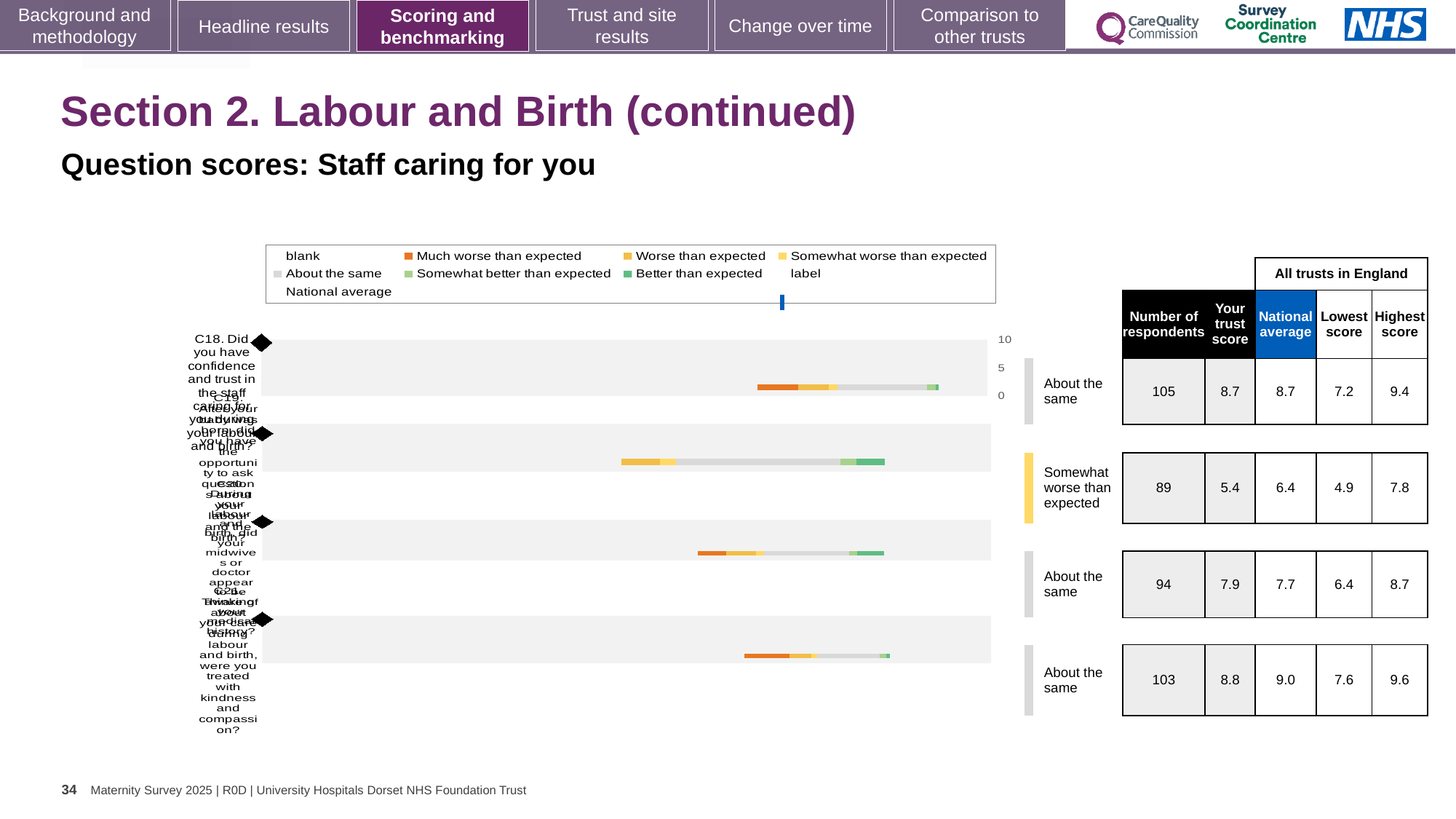
What colour is the band for the row rated 'Somewhat worse than expected'? yellow What is the lowest 'Your trust score' shown in the table? 5.4 What is the number of respondents for the row rated 'Somewhat worse than expected'? 89 What is the national average for the row rated 'Somewhat worse than expected'? 6.4 What is 'Your trust score' for the row rated 'Somewhat worse than expected'? 5.4 What kind of chart is shown on the slide? bar chart For the bottom row, what is the difference between the national average (9.0) and your trust score (8.8)? 0.2 How many of the four question rows are rated 'About the same'? 3 What is the highest 'Your trust score' shown in the table? 8.8 What is the highest score among all trusts in England for the top row? 9.4 For the third row, which is larger: your trust score or the national average? Your trust score How many question rows are plotted in the chart? 4